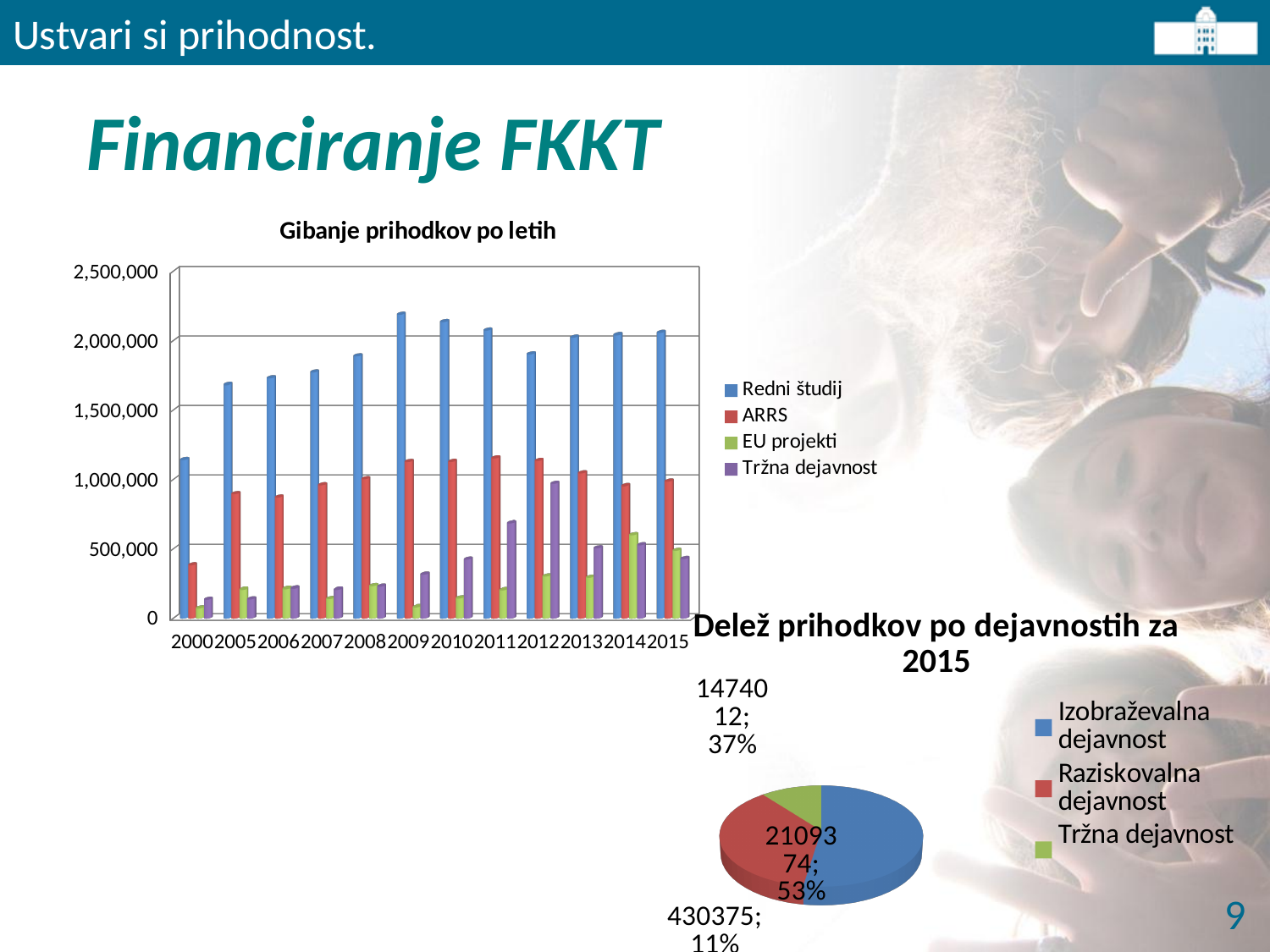
In 'Gibanje prihodkov po letih', which year has the highest value for Tržna dejavnost? 2012 In 'Gibanje prihodkov po letih', do the Redni študij values rise or fall from 2000 to 2009? rise In 'Gibanje prihodkov po letih', is the value for Redni študij in 2009 greater or less than 2,000,000? greater What kind of chart is 'Gibanje prihodkov po letih'? bar chart In 'Delež prihodkov po dejavnostih za 2015', what is the value for Tržna dejavnost? 430375 How many series does the legend of 'Gibanje prihodkov po letih' list? 4 In 'Gibanje prihodkov po letih', which year has the lowest value for Redni študij? 2000 What kind of chart is 'Delež prihodkov po dejavnostih za 2015'? pie chart In 'Gibanje prihodkov po letih', which is larger in 2015: ARRS or EU projekti? ARRS How many years are shown on the x axis of 'Gibanje prihodkov po letih'? 12 In 'Gibanje prihodkov po letih', is the value for Redni študij in 2000 greater or less than 1,500,000? less In 'Delež prihodkov po dejavnostih za 2015', what share does Izobraževalna dejavnost have? 53%